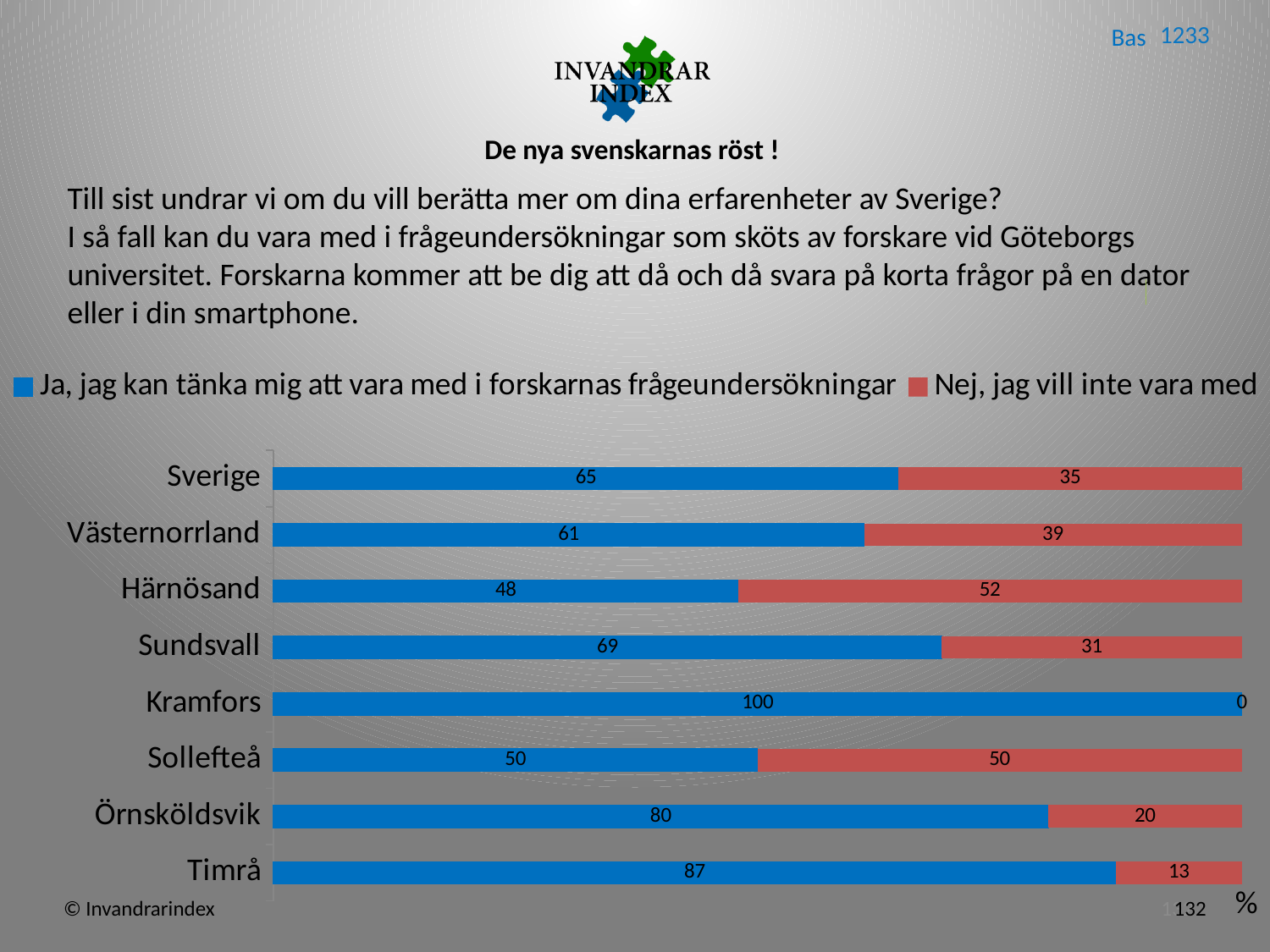
How many categories are shown on the chart? 8 What colour represents the series "Nej, jag vill inte vara med"? Red What kind of chart is shown on the slide? Stacked bar chart Which category has the highest value in the series "Ja, jag kan tänka mig att vara med i forskarnas frågeundersökningar"? Kramfors Which category has the lowest value in the series "Nej, jag vill inte vara med"? Kramfors What is the value for Timrå in the series "Ja, jag kan tänka mig att vara med i forskarnas frågeundersökningar"? 87 Which has a larger "Nej, jag vill inte vara med" value, Västernorrland or Sollefteå? Sollefteå What is the total of the stacked bar for Sollefteå? 100 What is the value for Sverige in the series "Ja, jag kan tänka mig att vara med i forskarnas frågeundersökningar"? 65 What is the difference between the "Ja" values for Örnsköldsvik and Sundsvall? 11 How many series does the legend list? 2 What is the value for Härnösand in the series "Nej, jag vill inte vara med"? 52